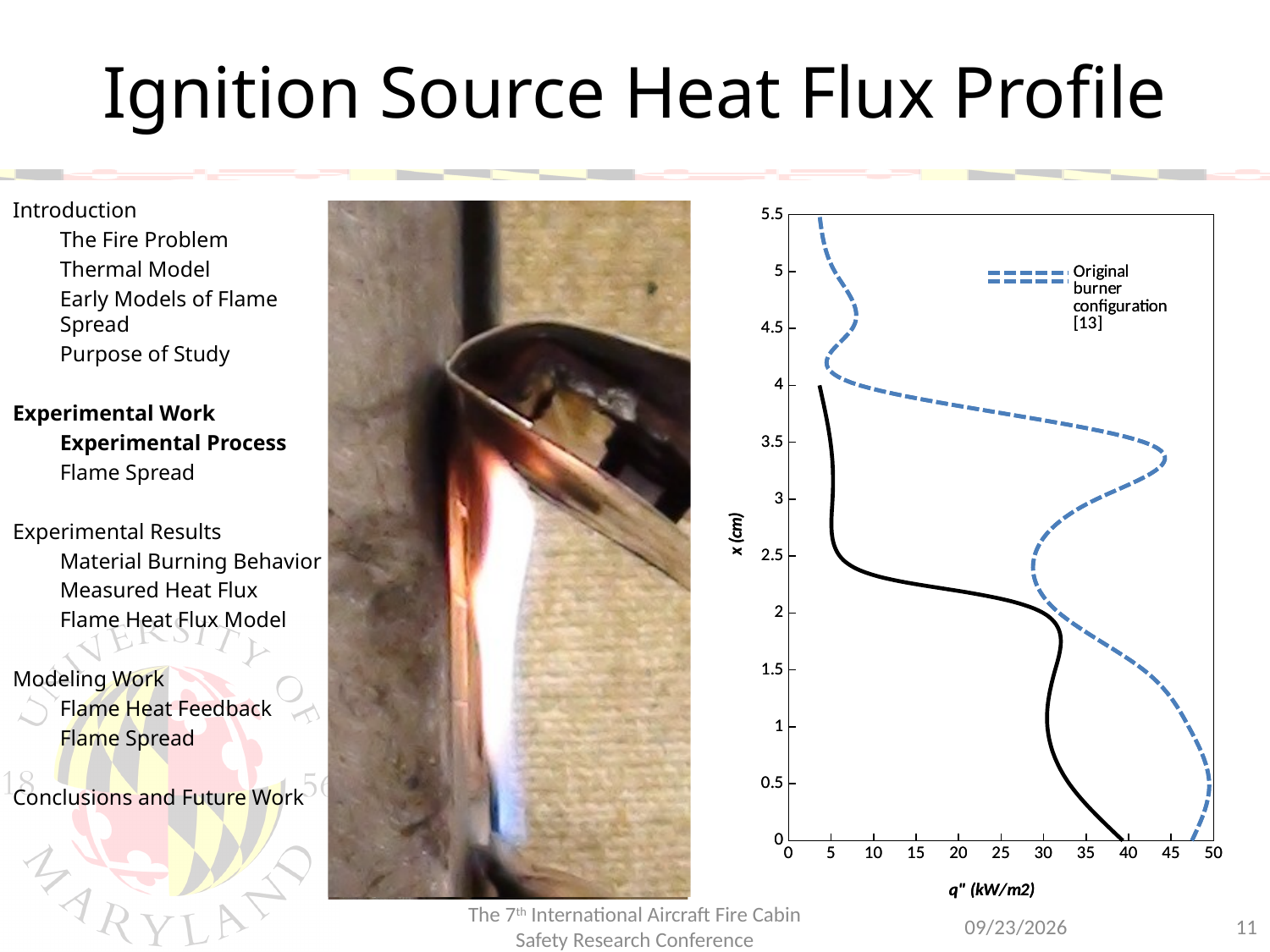
What is the label of the horizontal axis of the chart? q" (kW/m2) At x = 1 cm, which line shows the higher heat flux, the dashed 'Original burner configuration [13]' line or the solid black line? Original burner configuration [13] What entry does the chart's legend list? Original burner configuration [13] At x = 3 cm, which line shows the higher heat flux, the dashed 'Original burner configuration [13]' line or the solid black line? Original burner configuration [13] At x = 1 cm, is the heat flux of the solid black line greater or less than 25 kW/m2? greater Is the peak heat flux of the dashed 'Original burner configuration [13]' line greater or less than 40 kW/m2? greater How many entries does the chart's legend list? 1 At x = 4.5 cm, is the heat flux of the dashed 'Original burner configuration [13]' line greater or less than 10 kW/m2? less Moving from x = 0 cm up to x = 4 cm, does the heat flux of the solid black line overall rise or fall? fall What kind of chart is shown on the slide? line chart